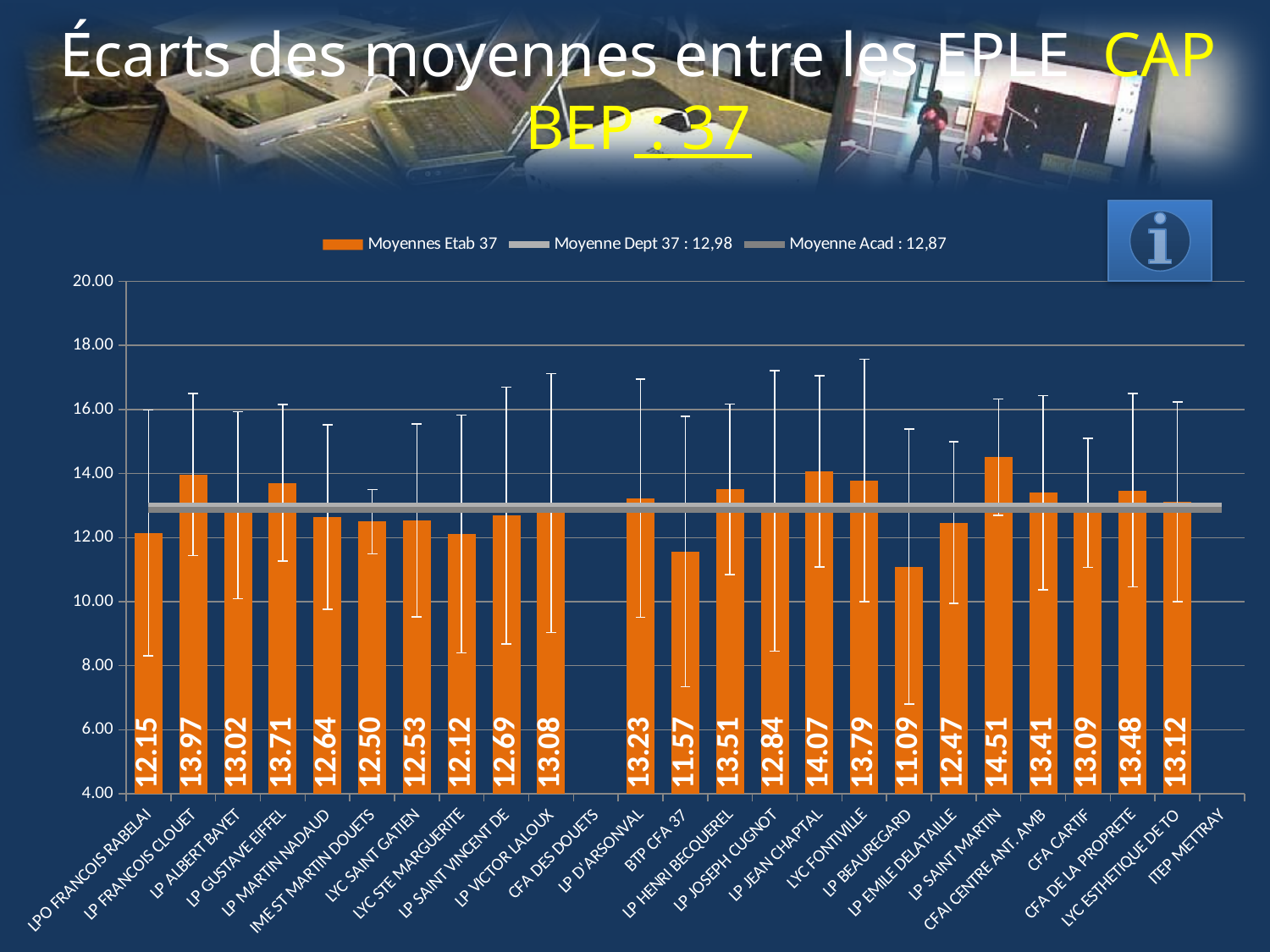
What is the difference between the values for LP FRANCOIS CLOUET and LPO FRANCOIS RABELAIS? 1.82 Which establishment has the highest value? LP SAINT MARTIN How many series does the legend list? 3 According to the legend, what is the value of Moyenne Dept 37? 12,98 Which is larger, the value for LP GUSTAVE EIFFEL or the value for LYC FONTIVILLE? LYC FONTIVILLE According to the legend, what is the value of Moyenne Acad? 12,87 What is the value for LP JEAN CHAPTAL? 14.07 What is the value for BTP CFA 37? 11.57 What kind of chart is shown on the slide? bar chart Is the value for LP BEAUREGARD greater or less than 12.00? less What is the value for CFA DE LA PROPRETE? 13.48 Which establishment has the lowest value? LP BEAUREGARD